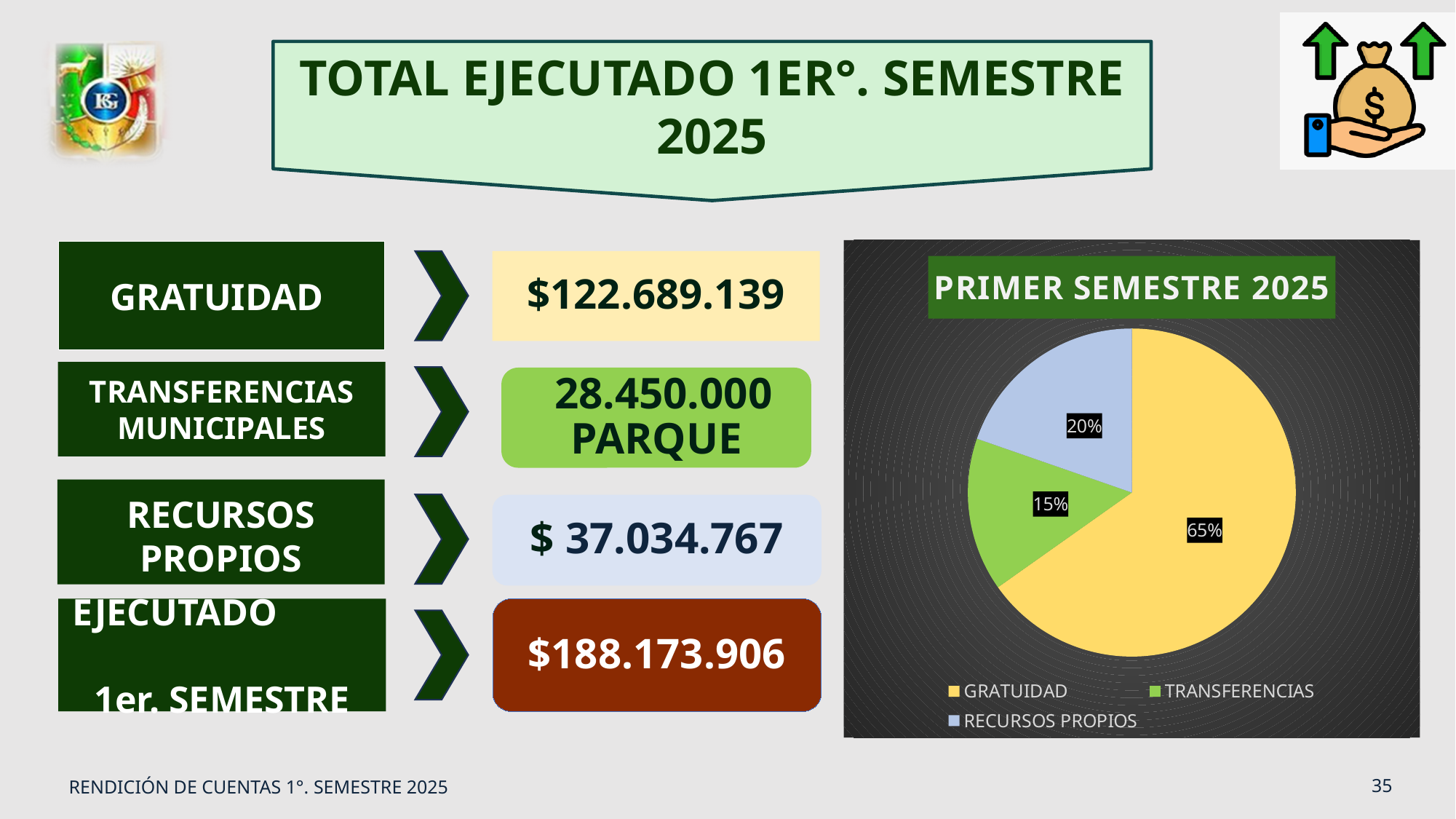
How many entries does the chart legend list? 3 What is the title of the chart? PRIMER SEMESTRE 2025 Which colour is used for the GRATUIDAD slice? yellow Which slice is larger, RECURSOS PROPIOS or TRANSFERENCIAS? RECURSOS PROPIOS Which category has the smallest slice of the pie? TRANSFERENCIAS What is the difference in percentage points between the GRATUIDAD slice and the RECURSOS PROPIOS slice? 45% Which category has the largest slice of the pie? GRATUIDAD What kind of chart is shown on the slide? pie chart What share of the pie does TRANSFERENCIAS represent? 15% What share of the pie does GRATUIDAD represent? 65% How many slices does the pie chart have? 3 What share of the pie does RECURSOS PROPIOS represent? 20%